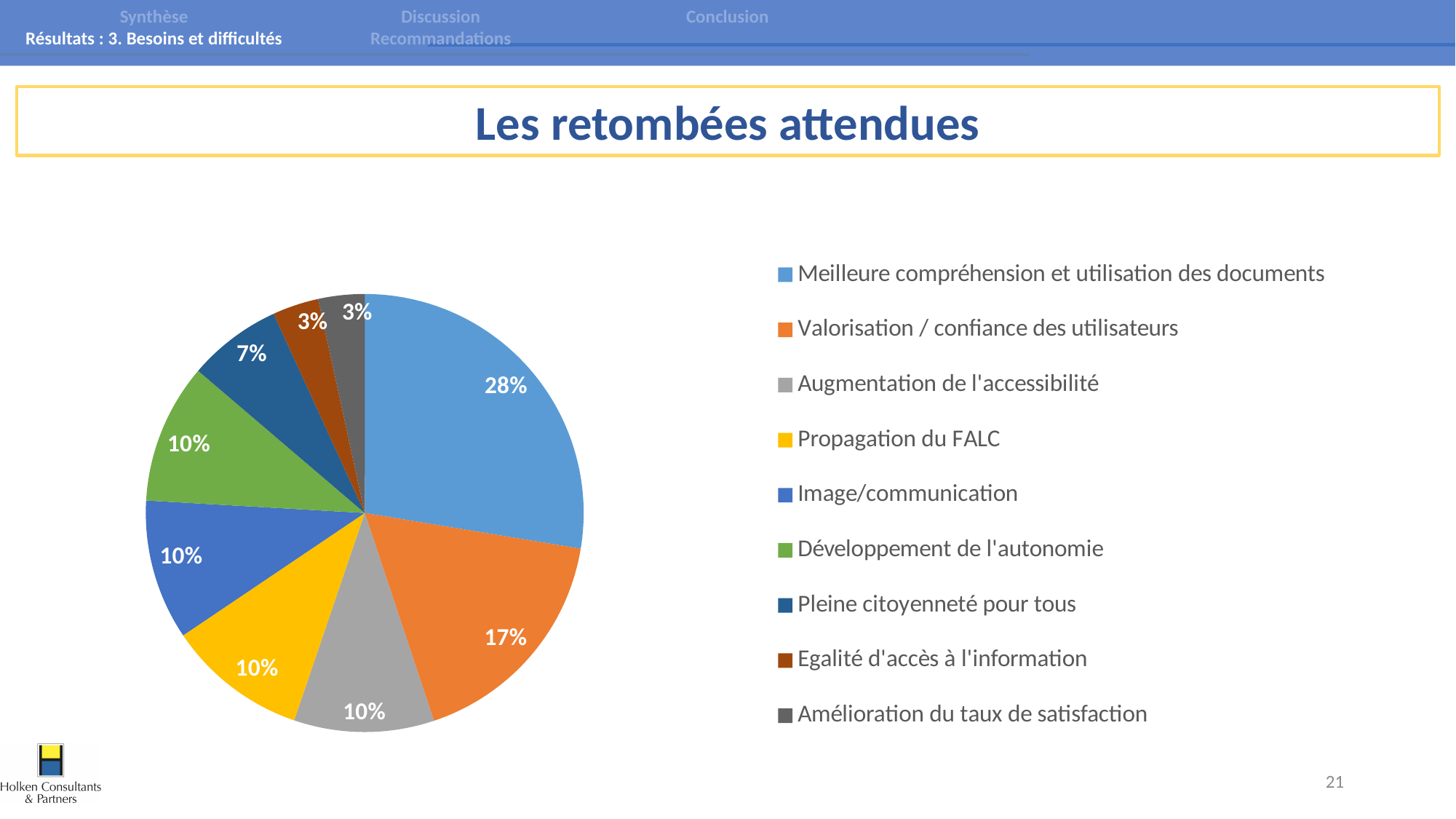
How many slices does the pie chart have? 9 What percentage is shown for 'Valorisation / confiance des utilisateurs'? 17% Which is larger: 'Pleine citoyenneté pour tous' or 'Développement de l'autonomie'? Développement de l'autonomie Which category has the largest share of the pie? Meilleure compréhension et utilisation des documents What percentage is shown for 'Egalité d'accès à l'information'? 3% What type of chart is shown on the slide? Pie chart What share of the pie is 'Meilleure compréhension et utilisation des documents'? 28% What percentage is shown for 'Propagation du FALC'? 10% What percentage is shown for 'Pleine citoyenneté pour tous'? 7% What is the difference in percentage points between 'Meilleure compréhension et utilisation des documents' and 'Valorisation / confiance des utilisateurs'? 11 What is the title of the slide containing the pie chart? Les retombées attendues What colour is the slice for 'Image/communication'? Blue